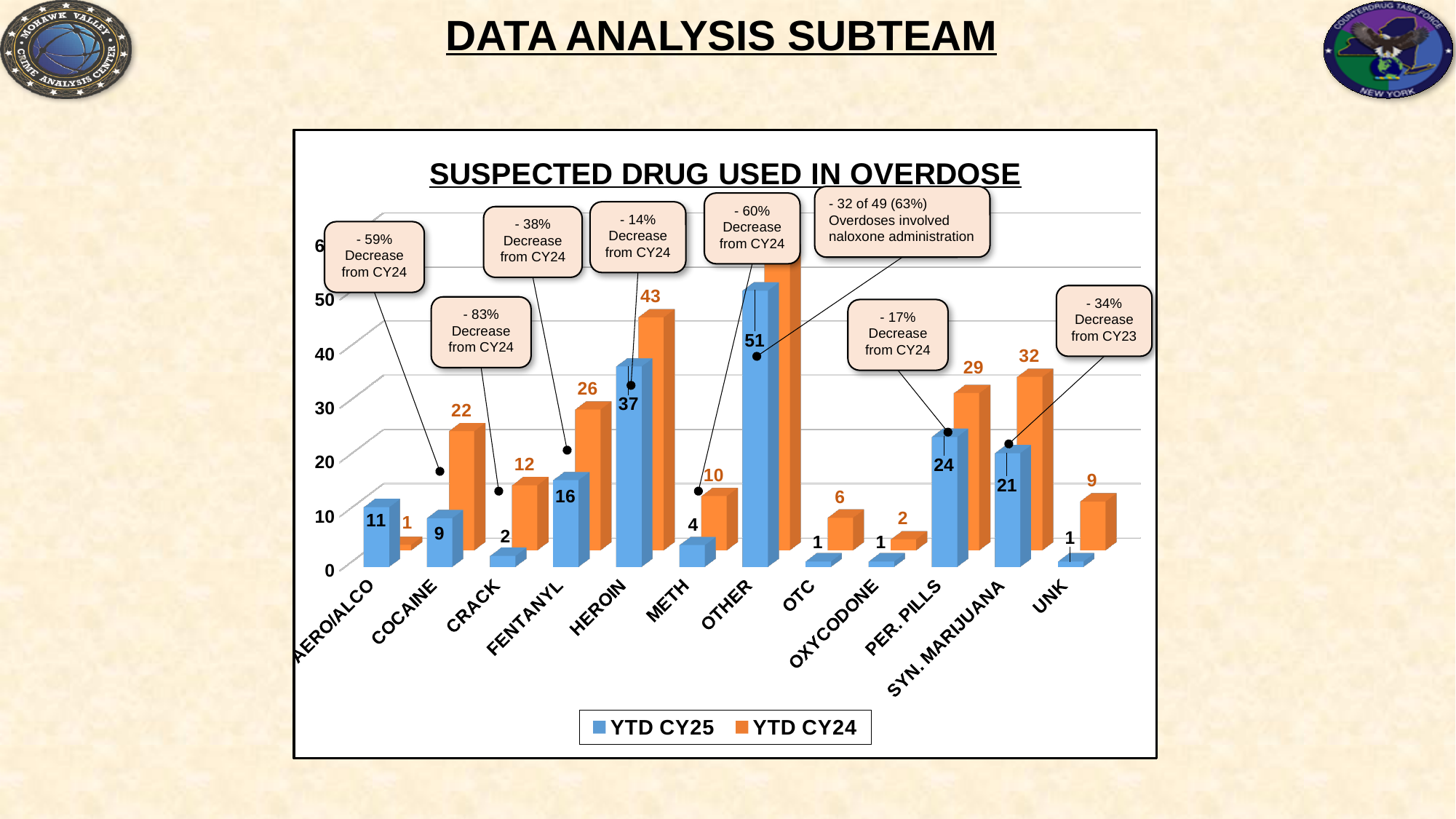
What is the difference between the YTD CY24 and YTD CY25 values for HEROIN? 6 Which category has the lowest YTD CY24 value? AERO/ALCO How many drug categories are shown on the x axis? 12 How many series does the legend list? 2 Is the YTD CY24 value for OTHER greater or less than 50? greater What is the difference between the YTD CY24 and YTD CY25 values for FENTANYL? 10 For COCAINE, which series has the larger value, YTD CY25 or YTD CY24? YTD CY24 What is the YTD CY25 value for PER. PILLS? 24 Which category has the highest YTD CY25 value? OTHER What is the YTD CY24 value for SYN. MARIJUANA? 32 What is the YTD CY25 value for HEROIN? 37 What kind of chart is shown on the slide? bar chart